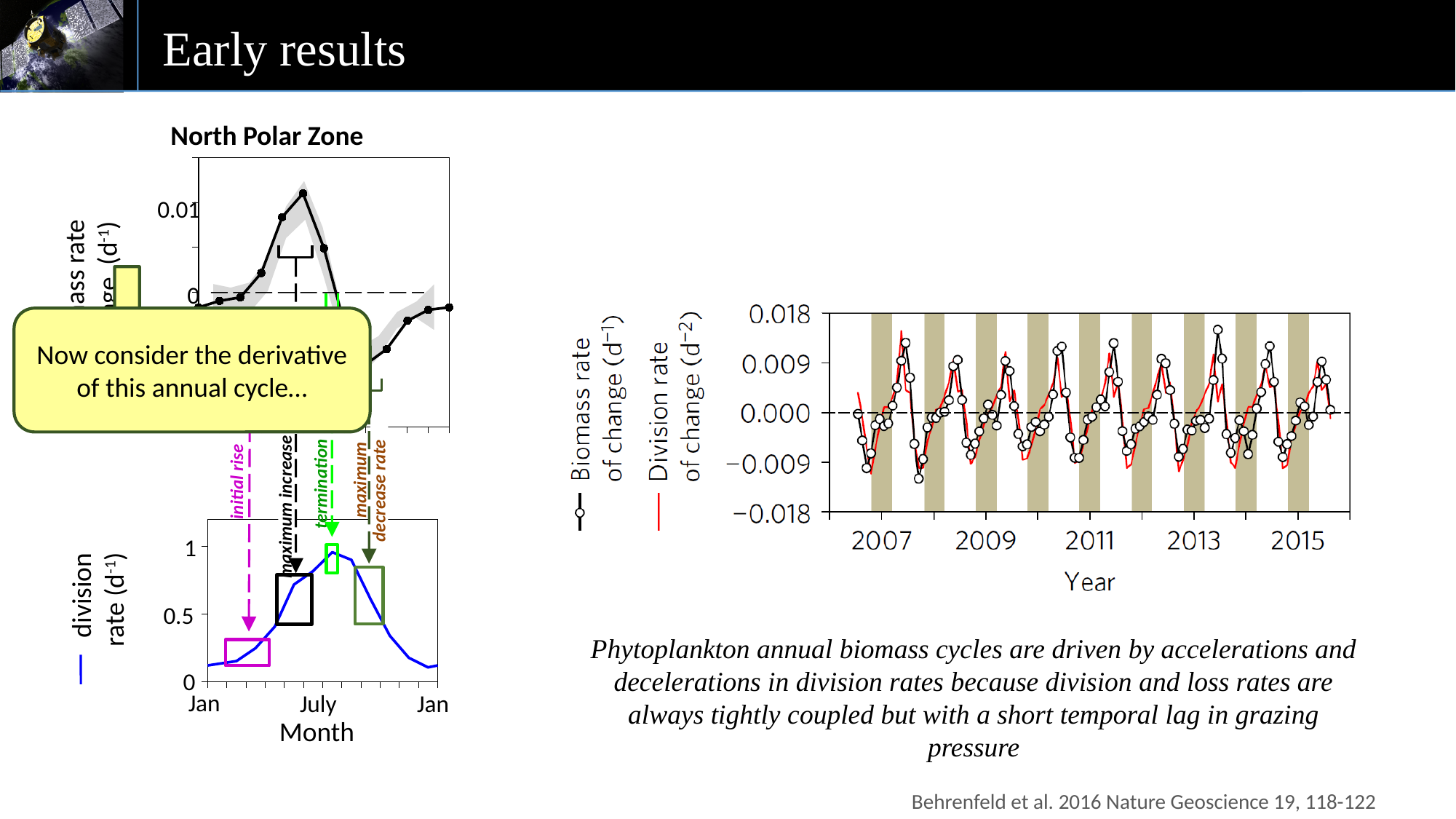
On the right-hand chart, is the peak of the biomass rate of change in 2007 greater or less than 0.009? greater On the right-hand chart (Biomass rate of change vs Year), how many series does the legend list? 2 On the right-hand chart, what is the label of the x axis? Year On the right-hand chart, what is the highest value shown on the y axis? 0.018 On the right-hand chart, which series is drawn in red? Division rate of change (d⁻²) On the right-hand chart, what are the two series named in the legend? Biomass rate of change (d⁻¹) and Division rate of change (d⁻²) On the right-hand chart, what is the lowest value shown on the y axis? -0.018 On the top-left chart titled North Polar Zone, is the peak biomass rate of change greater or less than 0.01? greater On the bottom-left chart (division rate vs Month), is the division rate in January greater or less than 0.5? less On the right-hand chart, what kind of chart is it? line chart On the bottom-left chart (division rate vs Month), what is the highest value shown on the y axis? 1